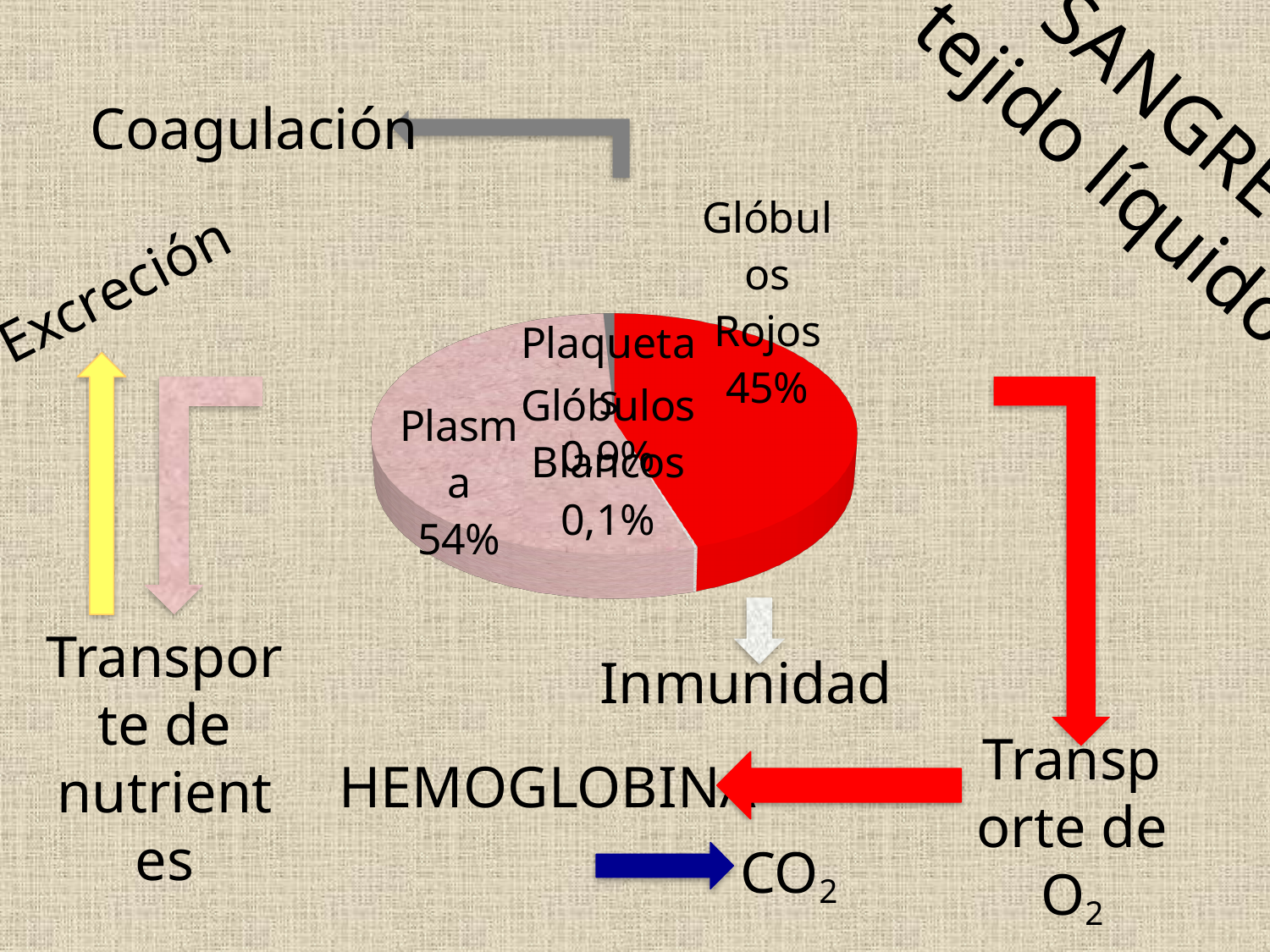
What percentage does the pie chart show for Glóbulos Blancos? 0,1% Which category has the largest slice of the pie chart? Plasma What share of the pie does Glóbulos Rojos represent? 45% What is the difference in percentage points between Plasma and Glóbulos Rojos? 9 What colour is the Glóbulos Rojos slice of the pie chart? red What kind of chart is shown on the slide? pie chart Which category has the smallest slice of the pie chart? Glóbulos Blancos What percentage does the pie chart show for Plasma? 54% How many categories are shown in the pie chart? 4 What percentage does the pie chart show for Glóbulos Rojos? 45% Which is larger in the pie chart, Plasma or Glóbulos Rojos? Plasma